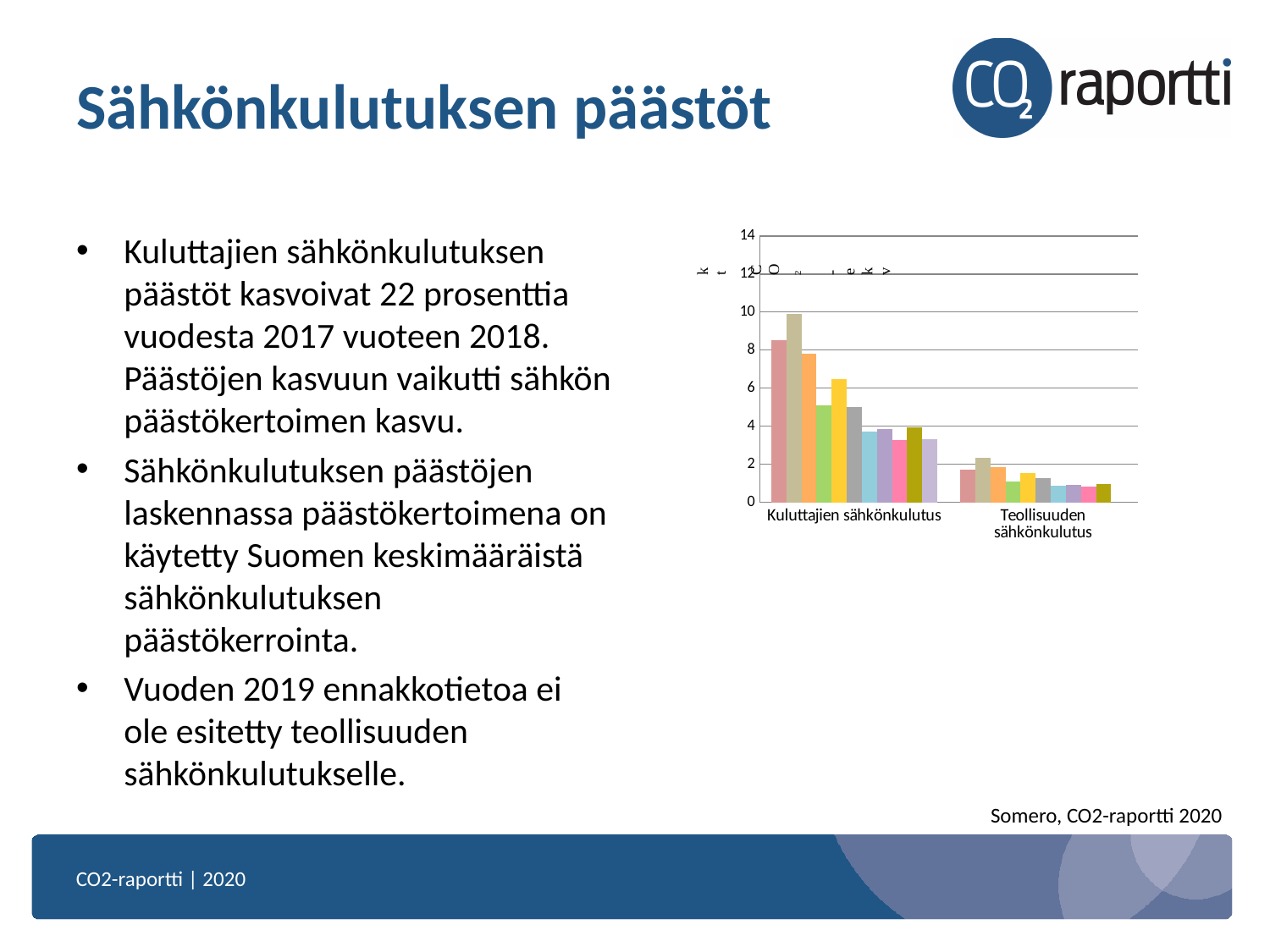
What is the highest value shown on the y axis of the chart? 14 What kind of chart is shown on the slide? bar chart Is the shortest bar for Kuluttajien sähkönkulutus greater or less than 2? greater Is the tallest bar for Kuluttajien sähkönkulutus greater or less than 8? greater Which category has the lower bars overall, Kuluttajien sähkönkulutus or Teollisuuden sähkönkulutus? Teollisuuden sähkönkulutus Is the first (leftmost) bar for Teollisuuden sähkönkulutus greater or less than 4? less What is the label of the right-hand category on the x axis of the chart? Teollisuuden sähkönkulutus How many categories are shown on the x axis of the chart? 2 Which category on the x axis contains the tallest bar in the chart? Kuluttajien sähkönkulutus